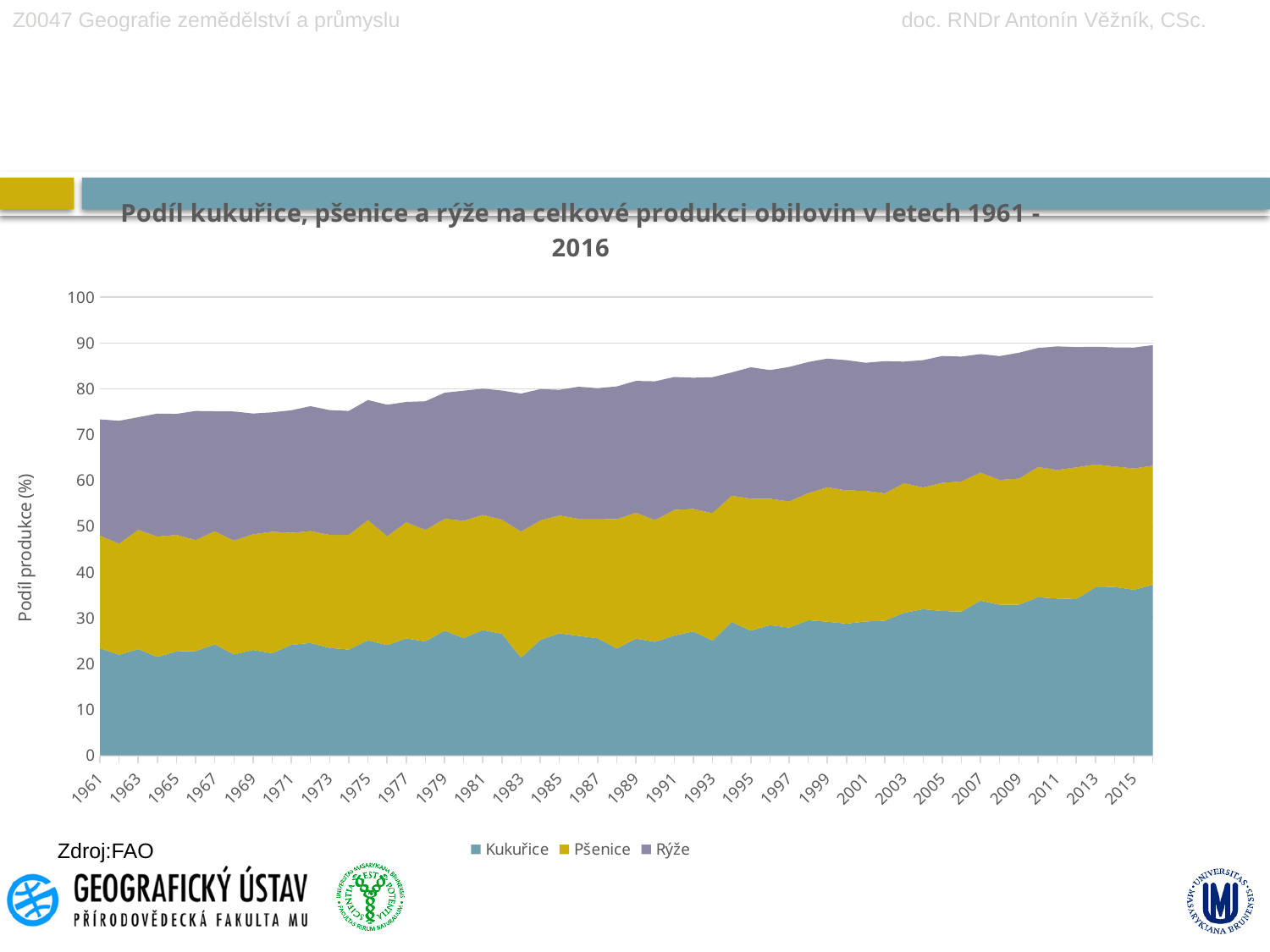
Does the share of Kukuřice generally rise or fall over the period shown? Rises Is the combined share of all three crops in 2015 greater or less than 80? greater How many series does the legend list? 3 Is the value for Kukuřice in 1961 greater or less than 30? less What kind of chart is shown on the slide? Stacked area chart Which three series are listed in the legend? Kukuřice, Pšenice, Rýže What is the label of the vertical axis? Podíl produkce (%) Is the value for Kukuřice in 2015 greater or less than 30? greater Does the combined share of the three crops rise or fall from 1961 to 2016? Rises Which series is plotted at the bottom of the stack? Kukuřice